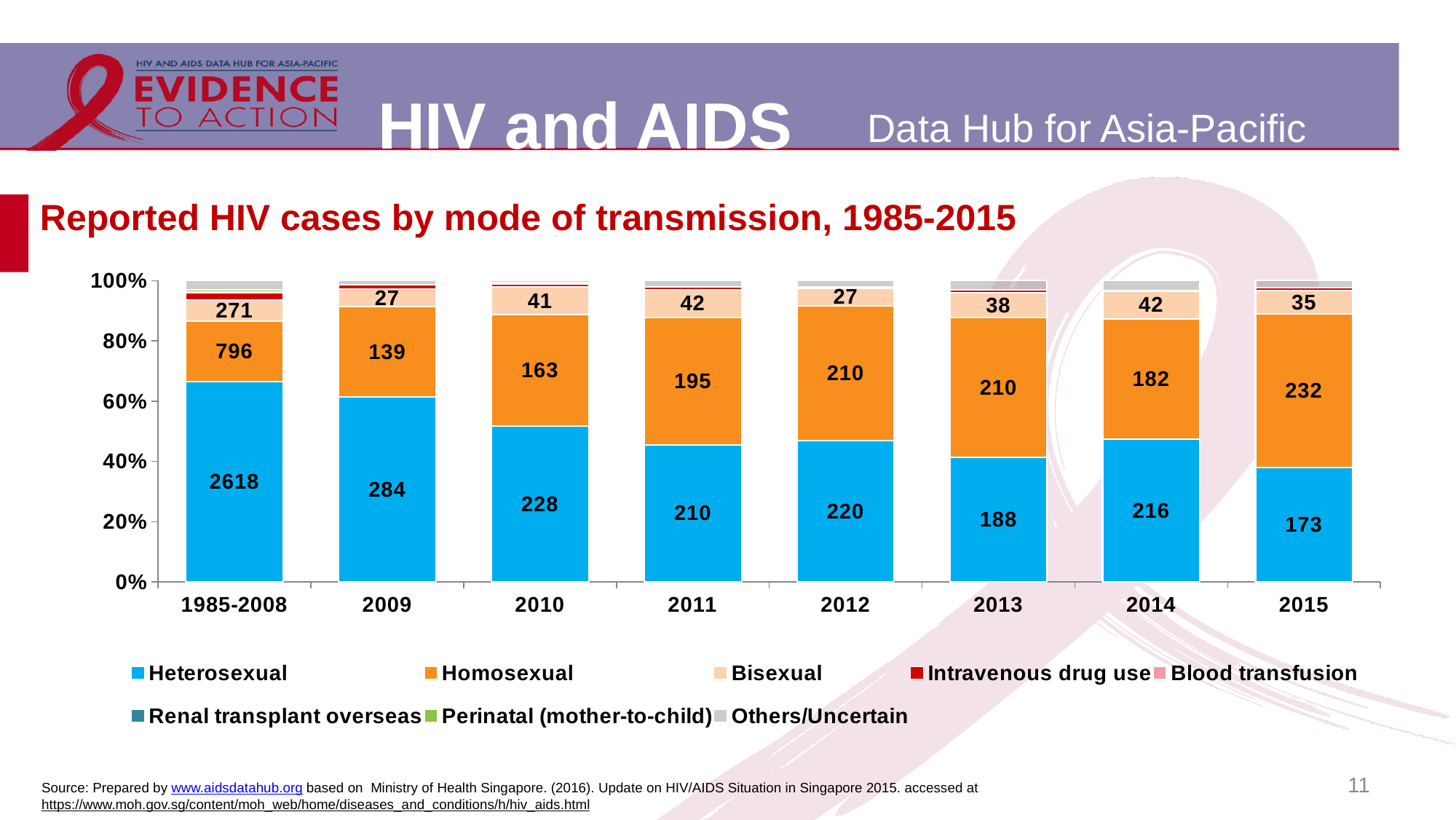
What is the value for Heterosexual in 2015? 173 What is the value for Heterosexual in the 1985-2008 period? 2618 What is the value for Homosexual in 2010? 163 How many series does the legend list? 8 What is the difference between the Heterosexual values for 2014 and 2013? 28 What is the value for Bisexual in 2011? 42 Which period has the lowest labelled Homosexual value? 2009 In 2012, which is larger: the Heterosexual value or the Homosexual value? Heterosexual Which period has the lowest labelled Heterosexual value? 2015 Is the Heterosexual share of the 2015 bar greater or less than 40%? less What is the difference between the Homosexual values for 2015 and 2014? 50 How many periods are shown on the x axis? 8